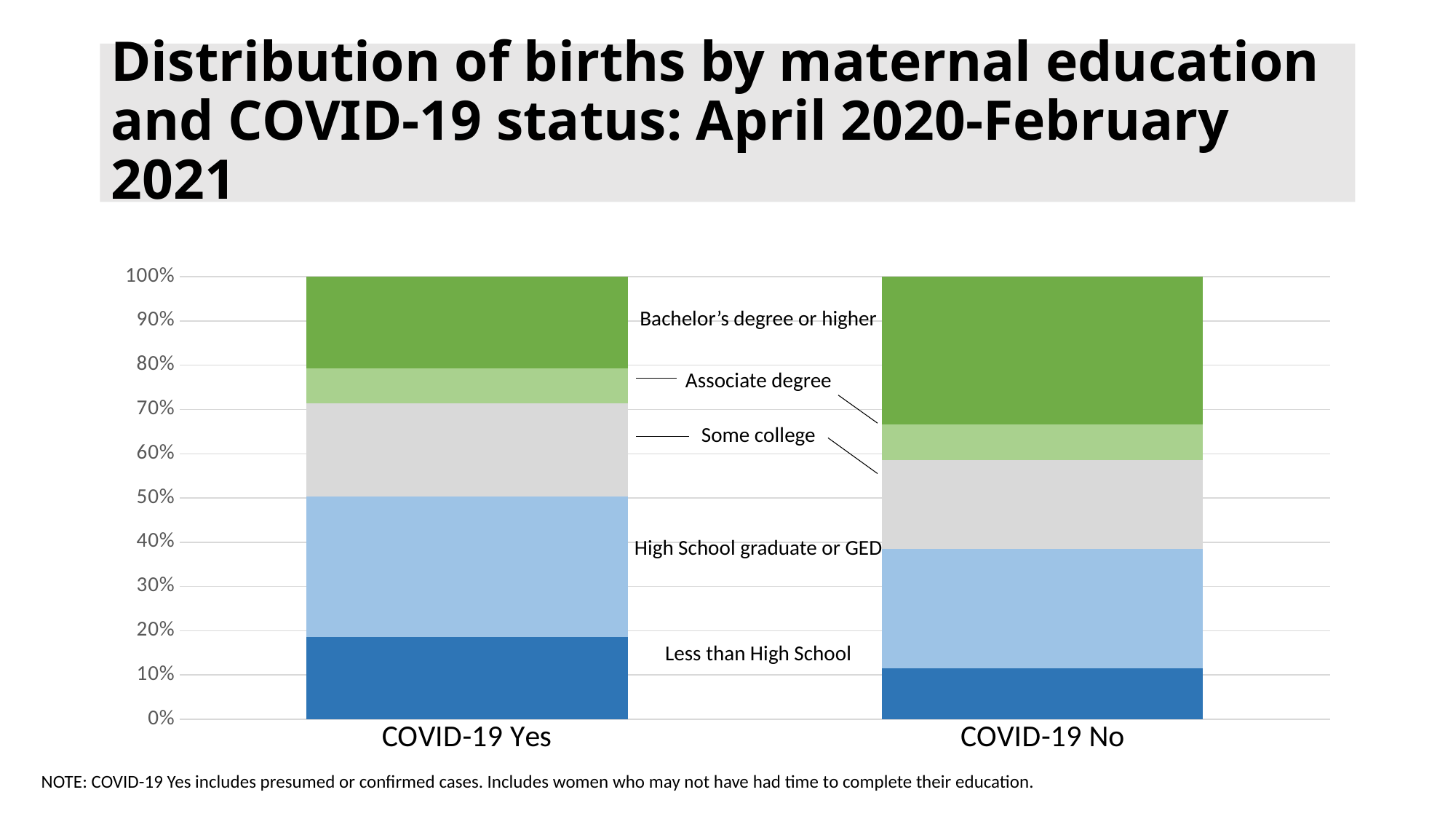
How many education-level series are labelled in the chart? 5 What time period does the chart title cover? April 2020-February 2021 What kind of chart is shown on the slide? Stacked bar chart Which category has the larger Bachelor's degree or higher share, COVID-19 Yes or COVID-19 No? COVID-19 No Is the Bachelor's degree or higher share for COVID-19 Yes greater or less than 30%? less Is the Less than High School share for COVID-19 No greater or less than 10%? greater Is the Bachelor's degree or higher share for COVID-19 No greater or less than 30%? greater Which education level is shown at the bottom of each stacked bar? Less than High School What is the total height of the COVID-19 Yes stacked bar? 100% Which category has the larger Less than High School share, COVID-19 Yes or COVID-19 No? COVID-19 Yes How many categories are shown on the x axis? 2